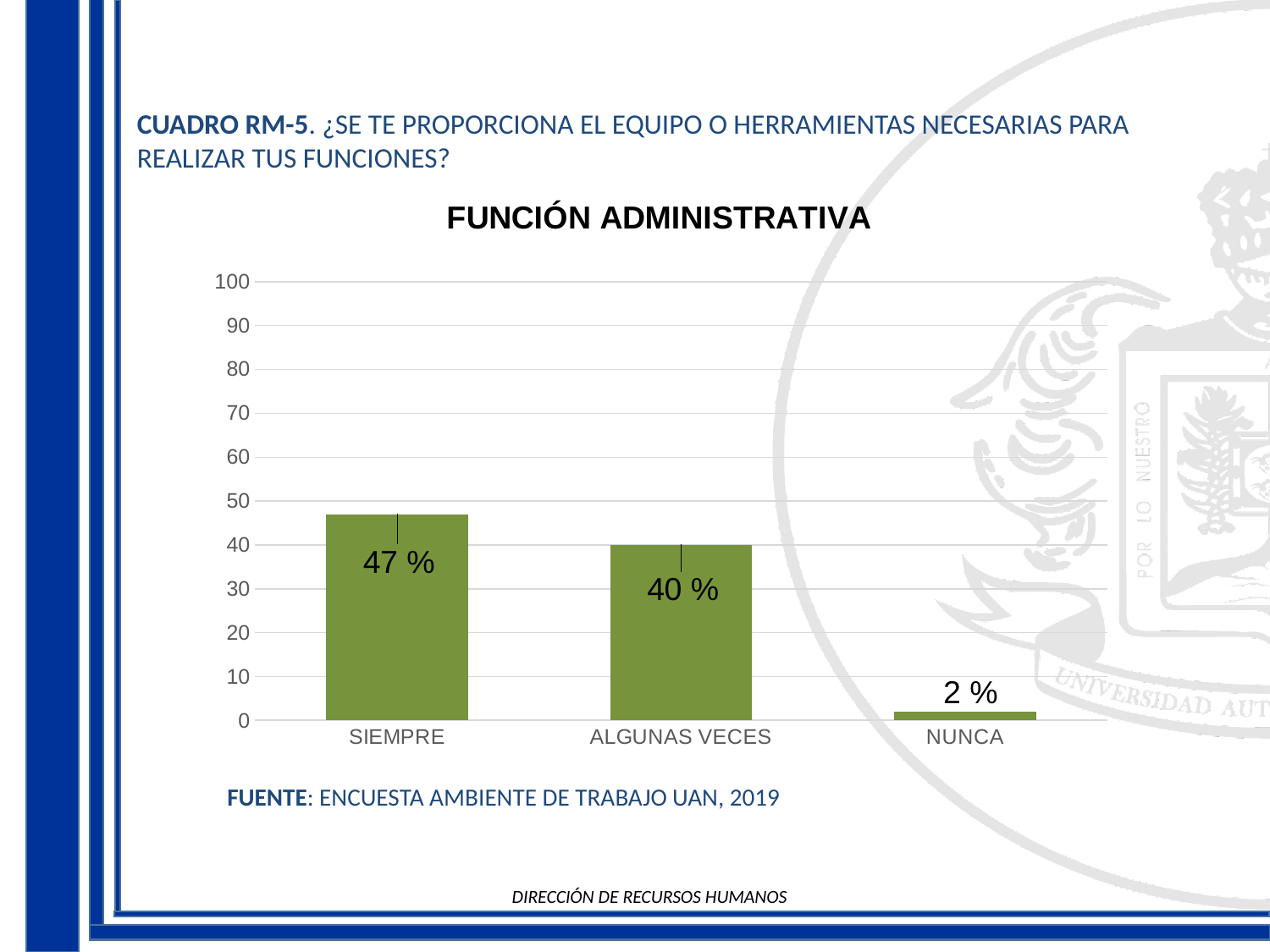
Is the value for ALGUNAS VECES greater or less than 50? less Which is larger, the value for SIEMPRE or the value for NUNCA? SIEMPRE What is the value for SIEMPRE? 47 % Which category has the lowest value? NUNCA What is the difference between the values for ALGUNAS VECES and NUNCA? 38 % What is the value for ALGUNAS VECES? 40 % What is the title of the chart? FUNCIÓN ADMINISTRATIVA What is the difference between the values for SIEMPRE and ALGUNAS VECES? 7 % How many categories are shown on the x axis? 3 Which category has the highest value? SIEMPRE What kind of chart is shown? bar chart What is the value for NUNCA? 2 %